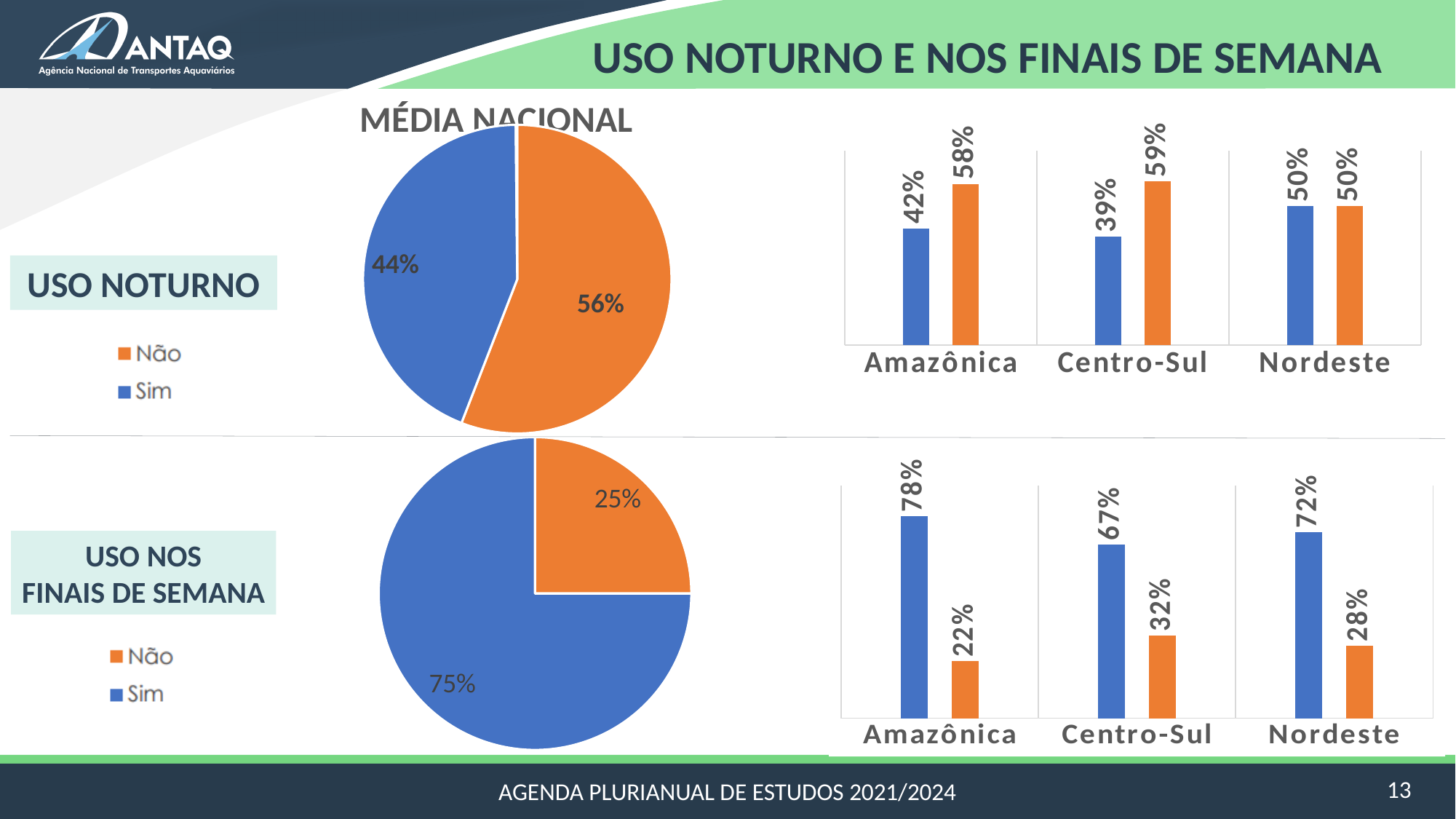
In the bottom-right bar chart (USO NOS FINAIS DE SEMANA by region), which region has the lowest 'Não' value? Amazônica In the top-right bar chart (USO NOTURNO by region), which is larger for Centro-Sul: 'Sim' or 'Não'? Não In the top-right bar chart (USO NOTURNO by region), what is the value of the 'Sim' bar for Centro-Sul? 39% In the bottom-right bar chart (USO NOS FINAIS DE SEMANA by region), which region has the highest 'Sim' value? Amazônica In the USO NOTURNO pie chart (top), what share of the pie is 'Não'? 56% How many regions are shown on the x axis of the bottom-right bar chart? 3 In the top-right bar chart (USO NOTURNO by region), what is the value of the 'Não' bar for Amazônica? 58% How many series does the legend for USO NOTURNO list? 2 What kind of chart is the MÉDIA NACIONAL chart for USO NOTURNO? Pie chart In the USO NOTURNO pie chart (top), what share of the pie is 'Sim'? 44% In the bottom-right bar chart (USO NOS FINAIS DE SEMANA by region), what is the difference between the 'Sim' and 'Não' values for Nordeste? 44% In the USO NOS FINAIS DE SEMANA pie chart (bottom), what share of the pie is 'Sim'? 75%